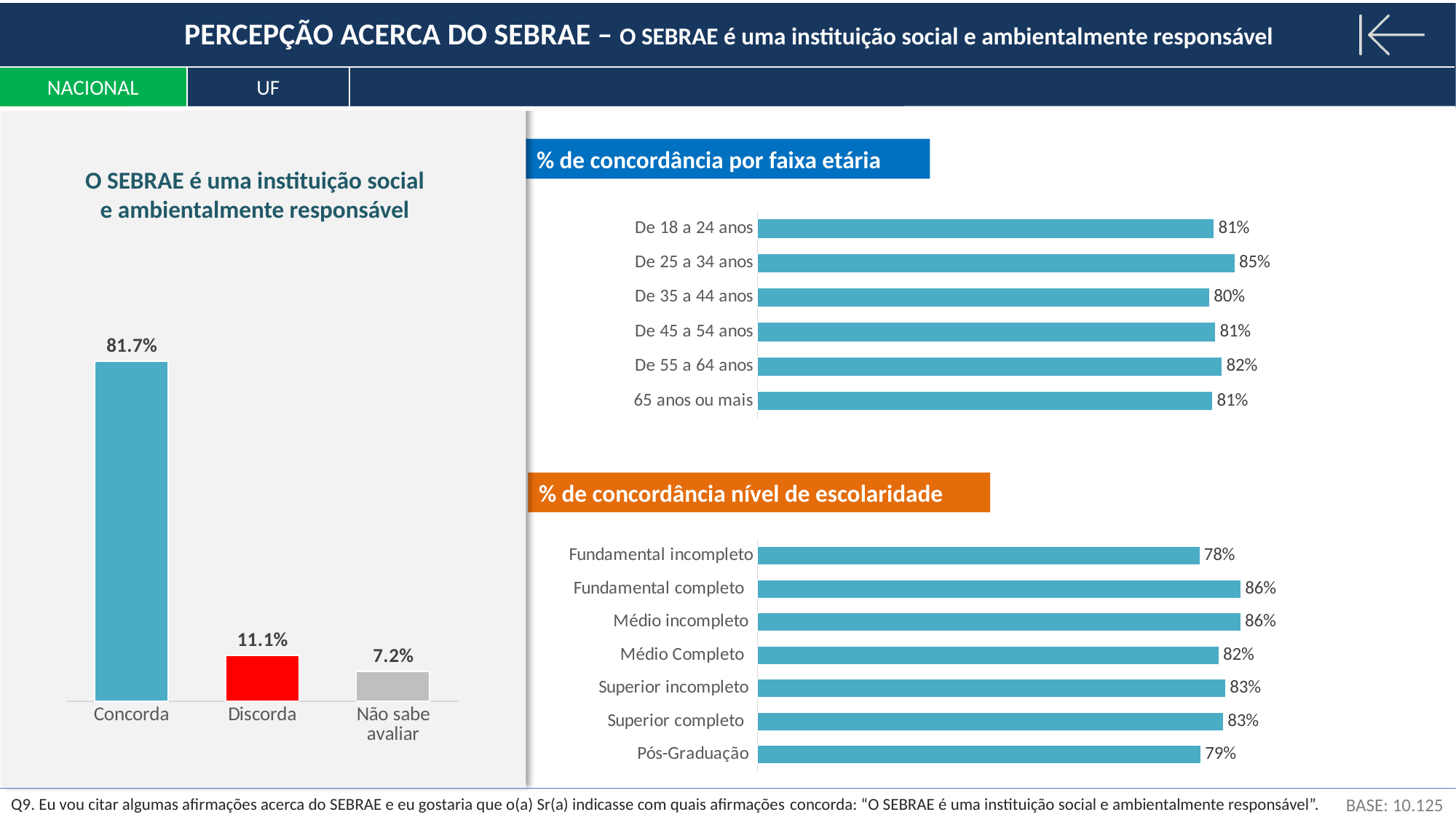
In the left chart 'O SEBRAE é uma instituição social e ambientalmente responsável', which category has the lowest value? Não sabe avaliar In the chart '% de concordância por faixa etária', which age group has the lowest value? De 35 a 44 anos In the left chart 'O SEBRAE é uma instituição social e ambientalmente responsável', what is the value for Concorda? 81.7% In the left chart 'O SEBRAE é uma instituição social e ambientalmente responsável', what is the value for Discorda? 11.1% In the chart '% de concordância nível de escolaridade', which category has the lowest value? Fundamental incompleto In the chart '% de concordância nível de escolaridade', what is the value for Pós-Graduação? 79% In the left chart 'O SEBRAE é uma instituição social e ambientalmente responsável', how many categories are shown? 3 In the left chart 'O SEBRAE é uma instituição social e ambientalmente responsável', what is the difference between Concorda and Discorda? 70.6% In the chart '% de concordância nível de escolaridade', what is the difference between Fundamental completo and Fundamental incompleto? 8% In the chart '% de concordância por faixa etária', how many age groups are shown? 6 In the chart '% de concordância por faixa etária', what is the value for De 25 a 34 anos? 85% In the chart '% de concordância por faixa etária', which age group has the highest value? De 25 a 34 anos